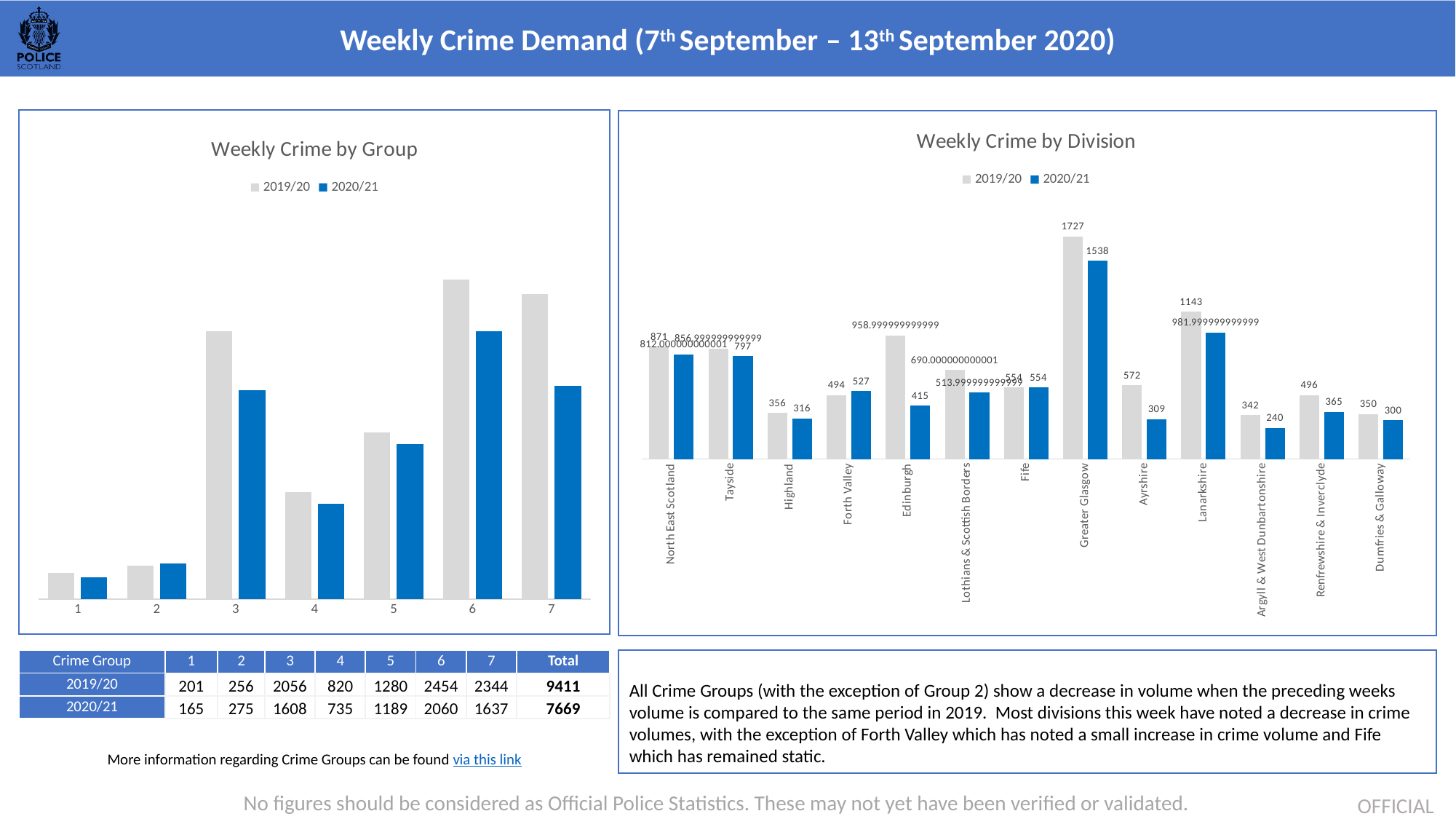
What kind of chart is the Weekly Crime by Group chart? bar chart In the Weekly Crime by Division chart, what is the 2020/21 value for Highland? 316 In the Weekly Crime by Division chart, which series has the larger value for Forth Valley, 2019/20 or 2020/21? 2020/21 How many crime groups are shown on the x axis of the Weekly Crime by Group chart? 7 In the Weekly Crime by Division chart, what is the difference between the 2019/20 and 2020/21 values for Ayrshire? 263 In the Weekly Crime by Division chart, which division has the highest 2020/21 value? Greater Glasgow In the Weekly Crime by Division chart, which division has the lowest 2020/21 value? Argyll & West Dunbartonshire In the Weekly Crime by Division chart, what is the difference between the 2019/20 and 2020/21 values for Greater Glasgow? 189 How many divisions are shown in the Weekly Crime by Division chart? 13 How many series does the legend of the Weekly Crime by Division chart list? 2 In the Weekly Crime by Division chart, what is the 2019/20 value for Ayrshire? 572 In the Weekly Crime by Division chart, what is the 2020/21 value for Greater Glasgow? 1538